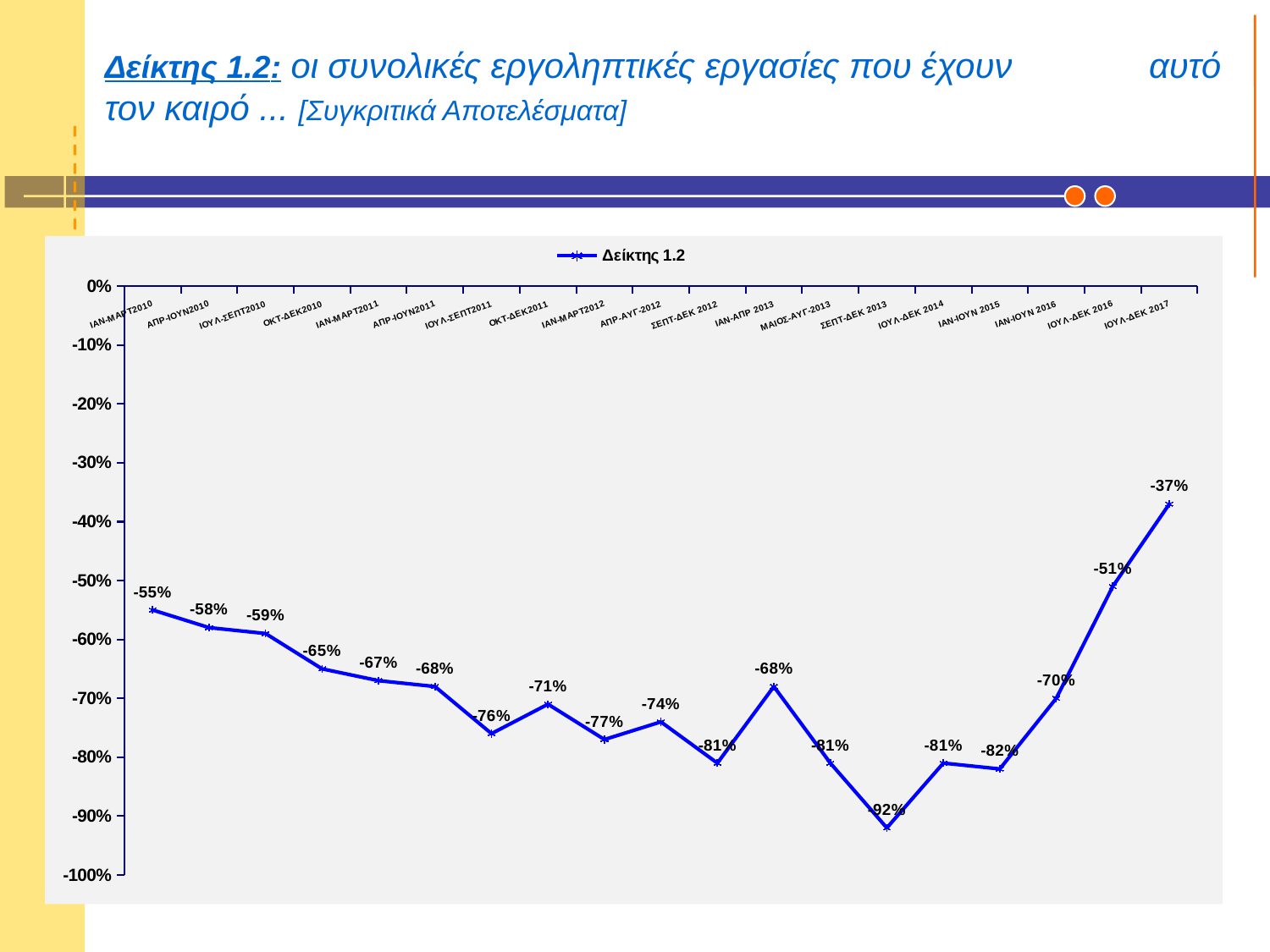
Which period has the highest value of Δείκτης 1.2? ΙΟΥΛ-ΔΕΚ 2017 How many periods are plotted on the x axis? 19 Which is higher: the value for ΙΑΝ-ΑΠΡ 2013 or the value for ΙΟΥΛ-ΣΕΠΤ2011? ΙΑΝ-ΑΠΡ 2013 What is the value of Δείκτης 1.2 for ΙΑΝ-ΙΟΥΝ 2016? -70% By how many percentage points does the value for ΙΟΥΛ-ΔΕΚ 2017 exceed the value for ΙΟΥΛ-ΔΕΚ 2016? 14 percentage points What kind of chart is shown on the slide? Line chart What is the value of Δείκτης 1.2 for ΣΕΠΤ-ΔΕΚ 2013? -92% What is the value of Δείκτης 1.2 for ΙΟΥΛ-ΔΕΚ 2017? -37% How many series does the legend list? 1 Do the values rise or fall from ΙΑΝ-ΙΟΥΝ 2015 to ΙΟΥΛ-ΔΕΚ 2017? Rise What is the value of Δείκτης 1.2 for ΙΑΝ-ΜΑΡΤ2010? -55% Which period has the lowest value of Δείκτης 1.2? ΣΕΠΤ-ΔΕΚ 2013